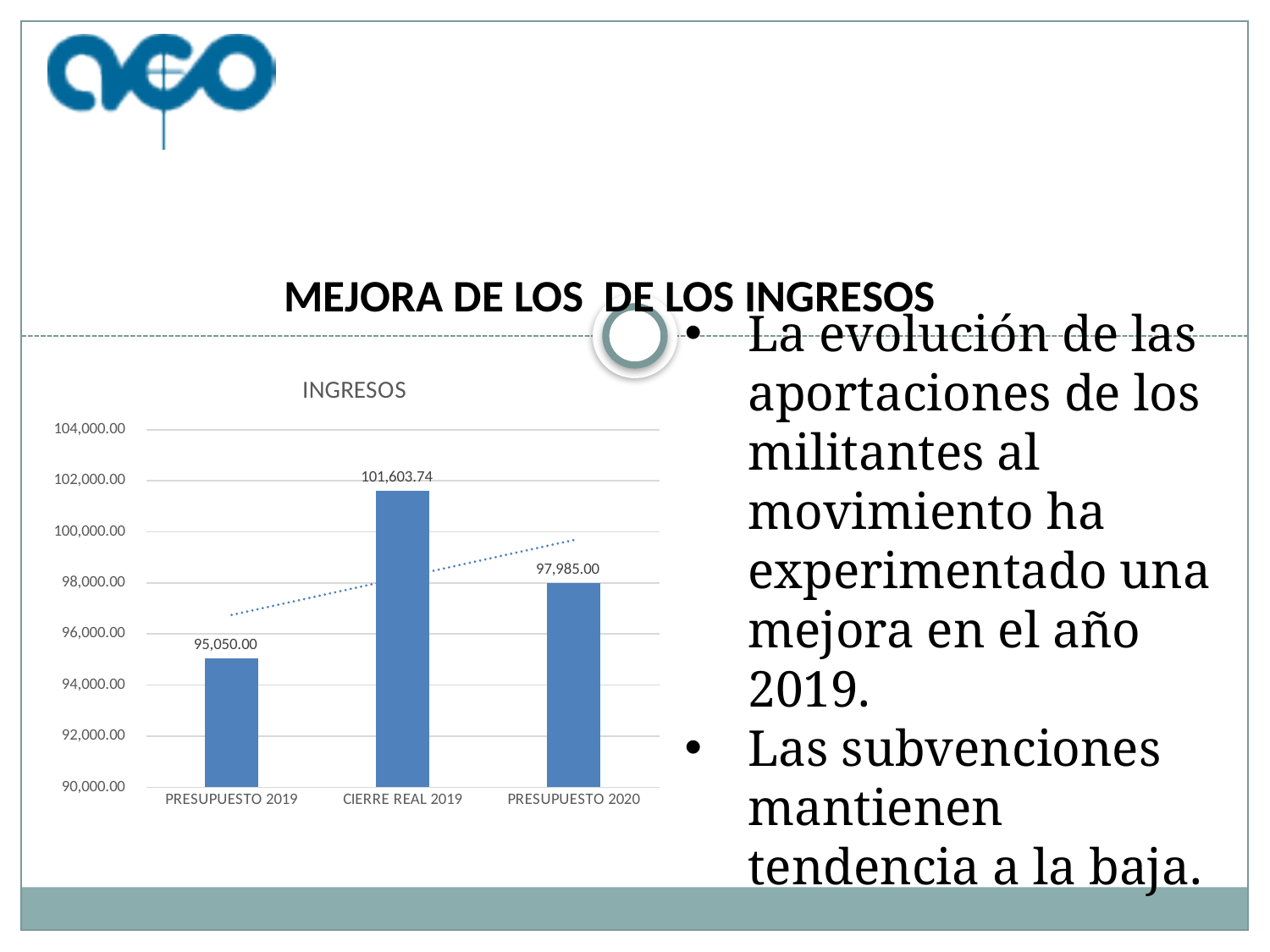
What is the value for PRESUPUESTO 2020 in the INGRESOS chart? 97,985.00 What is the value for CIERRE REAL 2019 in the INGRESOS chart? 101,603.74 Which category has the highest value in the INGRESOS chart? CIERRE REAL 2019 How many categories are shown in the INGRESOS chart? 3 Is the value for CIERRE REAL 2019 greater or less than 100,000.00? greater What is the difference between PRESUPUESTO 2020 and PRESUPUESTO 2019 in the INGRESOS chart? 2,935.00 Which category has the lowest value in the INGRESOS chart? PRESUPUESTO 2019 What is the difference between CIERRE REAL 2019 and PRESUPUESTO 2019 in the INGRESOS chart? 6,553.74 What is the title of the chart on the slide? INGRESOS What kind of chart is the INGRESOS chart? Bar chart What is the value for PRESUPUESTO 2019 in the INGRESOS chart? 95,050.00 Which is larger in the INGRESOS chart, PRESUPUESTO 2020 or PRESUPUESTO 2019? PRESUPUESTO 2020